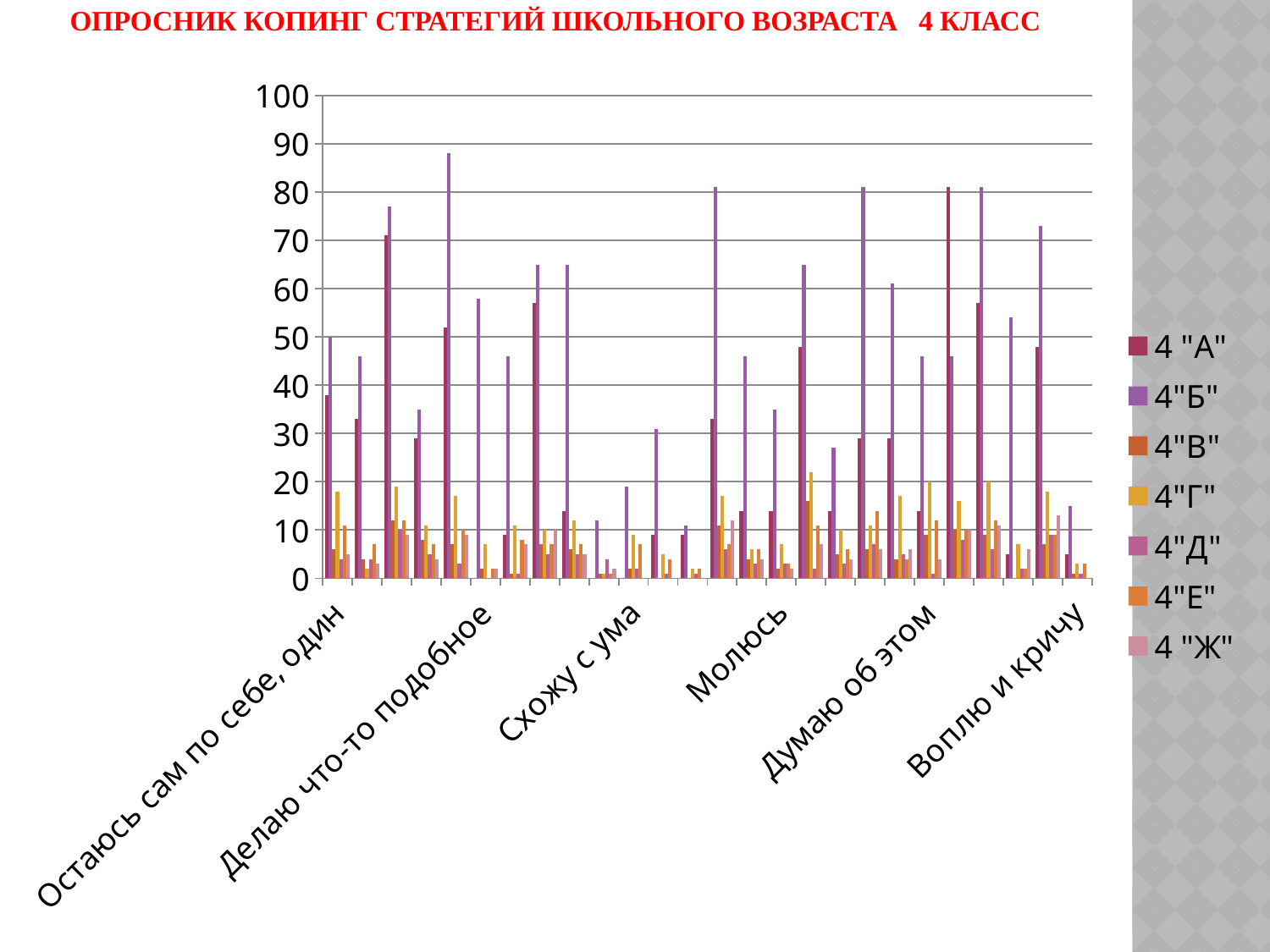
What kind of chart is shown on the slide? bar chart How many series does the legend list? 7 What is the title of the slide? ОПРОСНИК КОПИНГ СТРАТЕГИЙ ШКОЛЬНОГО ВОЗРАСТА 4 КЛАСС Is the tallest bar on the chart greater or less than 90? less Is the tallest bar on the chart greater or less than 80? greater Which series has the tallest bar on the chart? 4"Б" Which series is listed first in the legend? 4 "А"